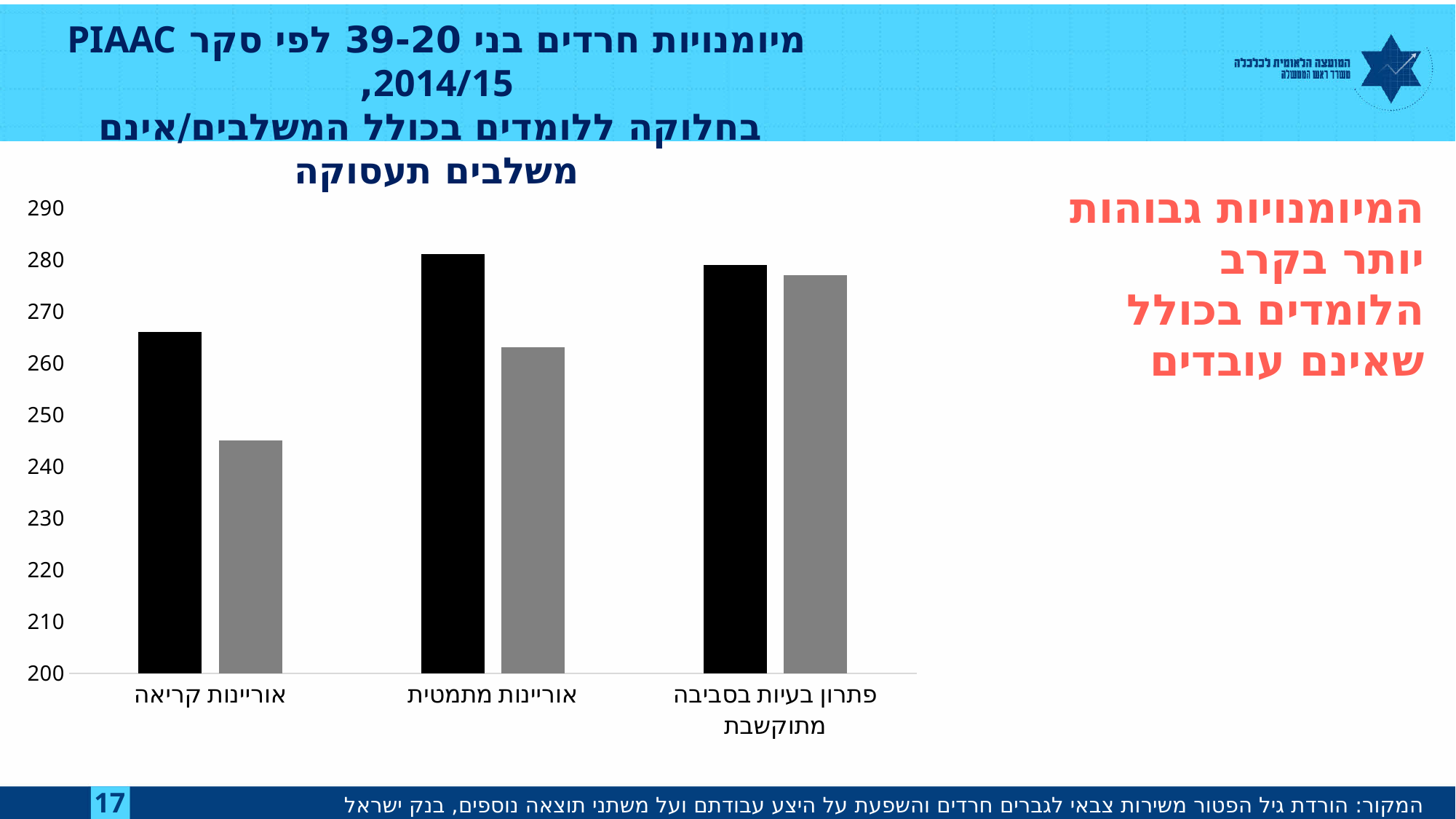
Is the gray bar for אוריינות מתמטית greater or less than 270? less Is the black bar for אוריינות מתמטית greater or less than 270? greater Is the black bar for אוריינות קריאה greater or less than 260? greater For אוריינות קריאה, which bar is larger, the black bar or the gray bar? the black bar Which category has the highest gray bar? פתרון בעיות בסביבה מתוקשבת What kind of chart is shown on the slide? bar chart What is the lowest value shown on the vertical axis of the chart? 200 How many bars are shown for each category in the chart? 2 Which category has the lowest gray bar? אוריינות קריאה How many categories are shown on the x axis of the chart? 3 Which category has the lowest black bar? אוריינות קריאה